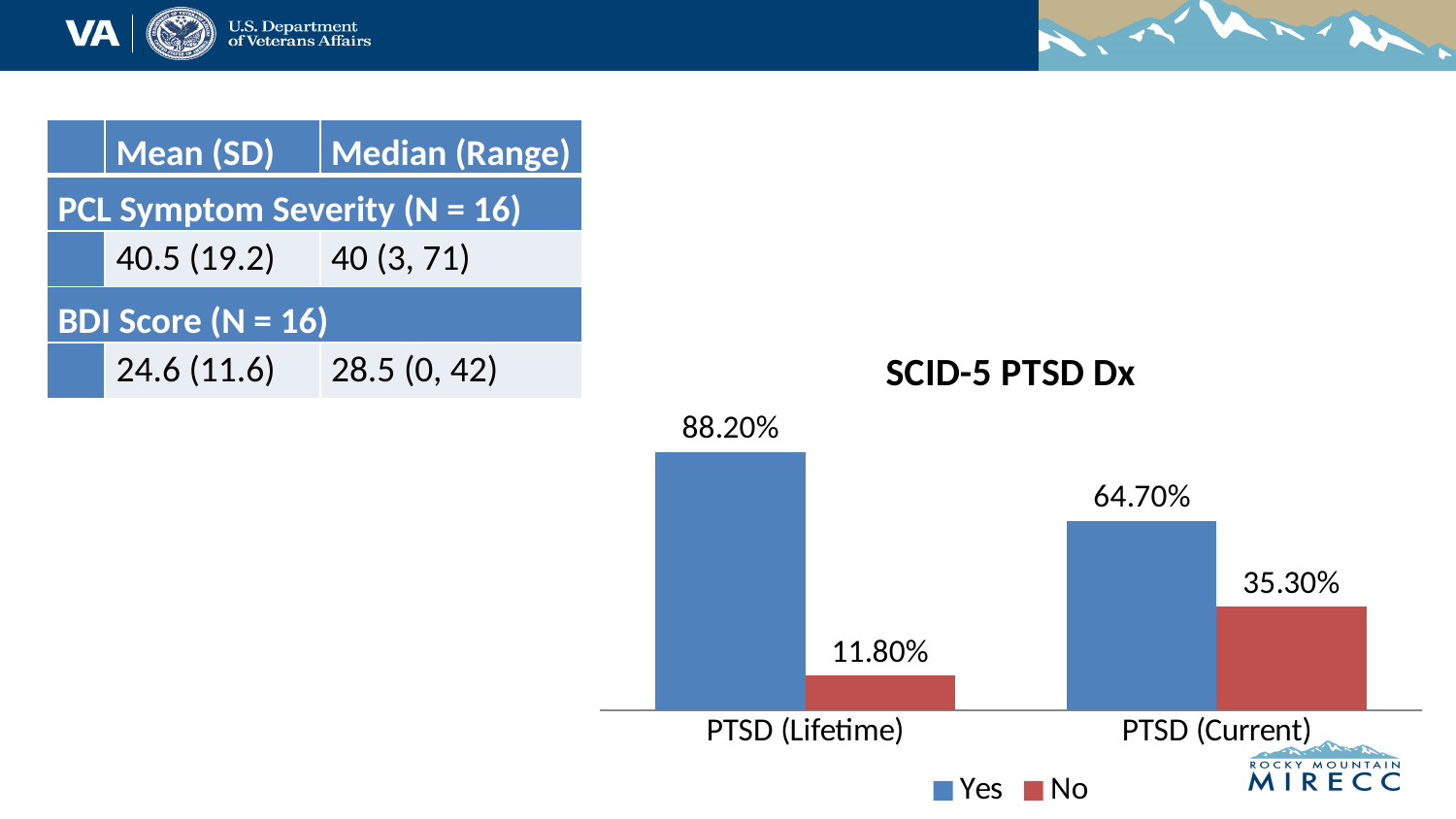
Which is larger, the No value for PTSD (Lifetime) or the No value for PTSD (Current)? PTSD (Current) What is the value for No in the PTSD (Current) category? 35.30% What is the title of the chart? SCID-5 PTSD Dx What is the difference between the Yes and No values for PTSD (Current)? 29.40% Which category has the lowest No value? PTSD (Lifetime) What is the difference between the Yes values for PTSD (Lifetime) and PTSD (Current)? 23.50% What is the value for Yes in the PTSD (Lifetime) category? 88.20% What is the value for Yes in the PTSD (Current) category? 64.70% How many categories are shown on the x axis of the chart? 2 How many series does the chart legend list? 2 Which category has the highest Yes value? PTSD (Lifetime) What is the value for No in the PTSD (Lifetime) category? 11.80%